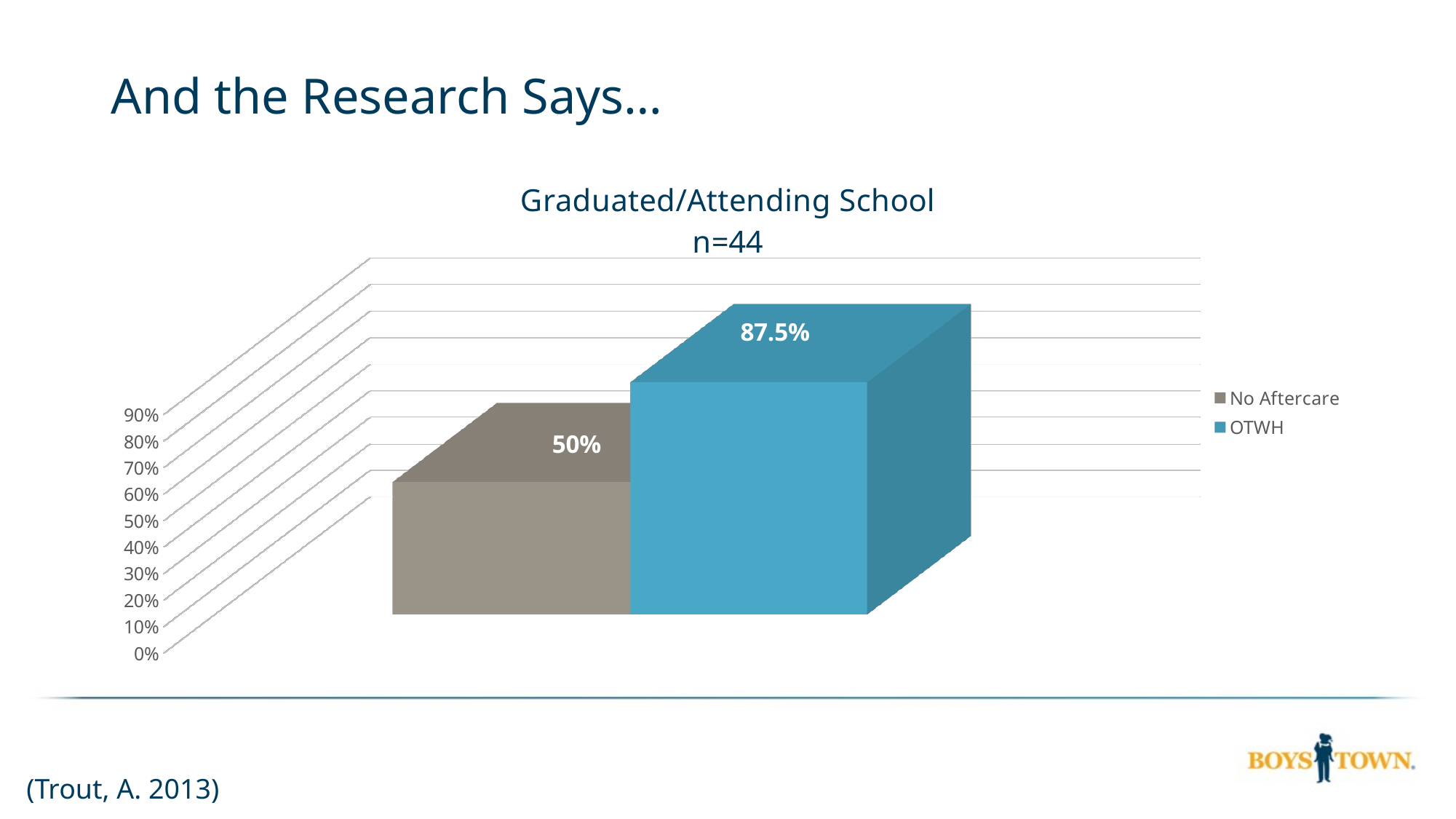
Which is larger, the value for OTWH or the value for No Aftercare? OTWH What colour is the OTWH bar? blue What is the title of the chart? Graduated/Attending School n=44 What kind of chart is shown on the slide? bar chart Is the value for OTWH greater or less than 80%? greater What is the value for OTWH? 87.5% What is the difference between the OTWH value and the No Aftercare value? 37.5% Which series has the highest value? OTWH How many series does the legend list? 2 Which series has the lowest value? No Aftercare Is the value for No Aftercare greater or less than 60%? less What is the value for No Aftercare? 50%